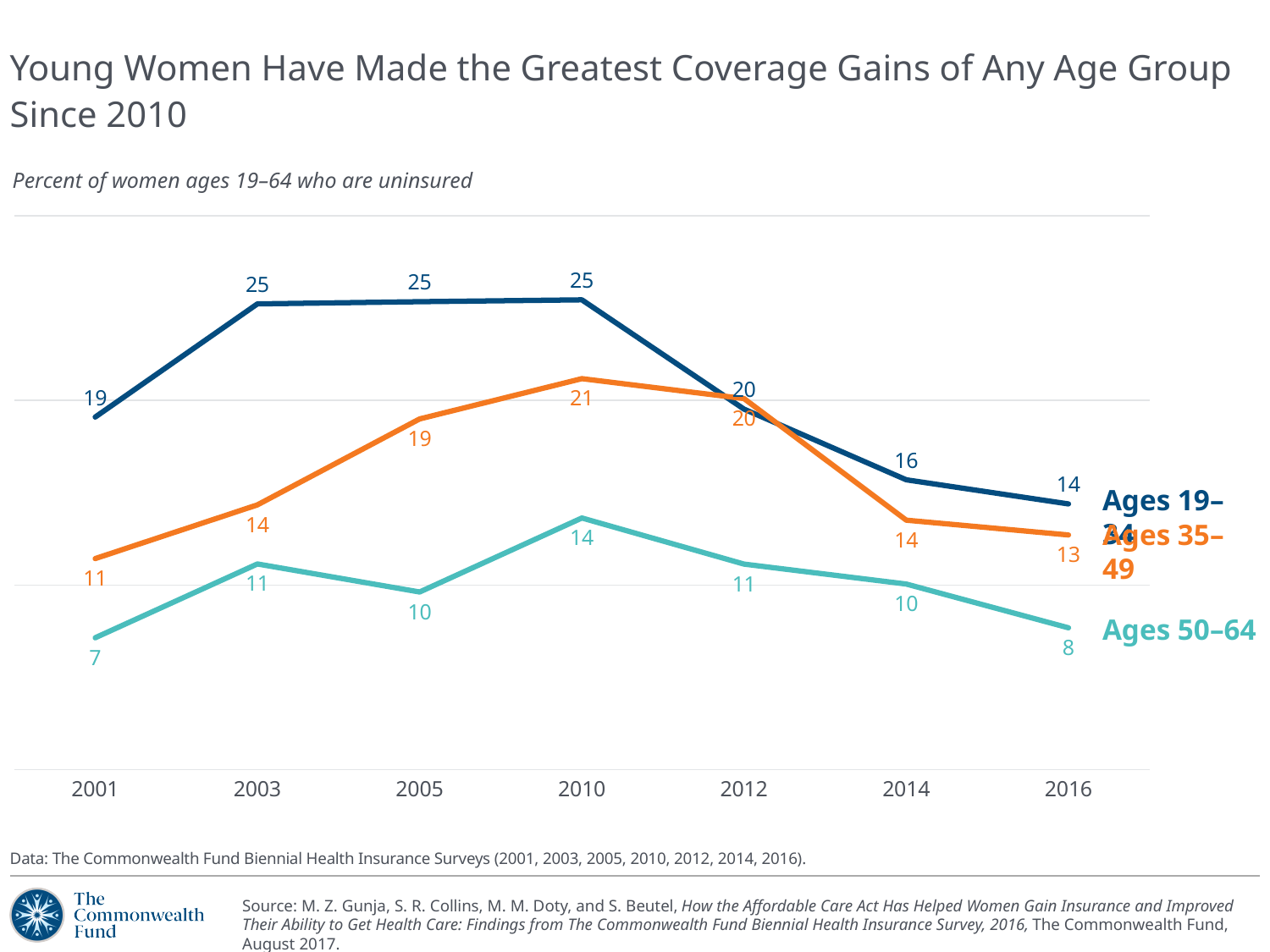
What type of chart is shown on the slide? line chart In which year was the value for Ages 50–64 lowest? 2001 How many series (age groups) are plotted on the chart? 3 Which age group had the higher uninsured rate in 2005, Ages 35–49 or Ages 50–64? Ages 35–49 Does the Ages 50–64 series rise or fall between 2010 and 2016? fall By how many percentage points did the Ages 19–34 value fall from 2010 to 2016? 11 How many years are shown along the x axis? 7 In which year did the Ages 35–49 series reach its highest value? 2010 What is the subtitle describing the measure plotted on the chart? Percent of women ages 19–64 who are uninsured What percent of women ages 35–49 were uninsured in 2010? 21 What is the value for the Ages 19–34 series in 2016? 14 What percent of women ages 50–64 were uninsured in 2001? 7